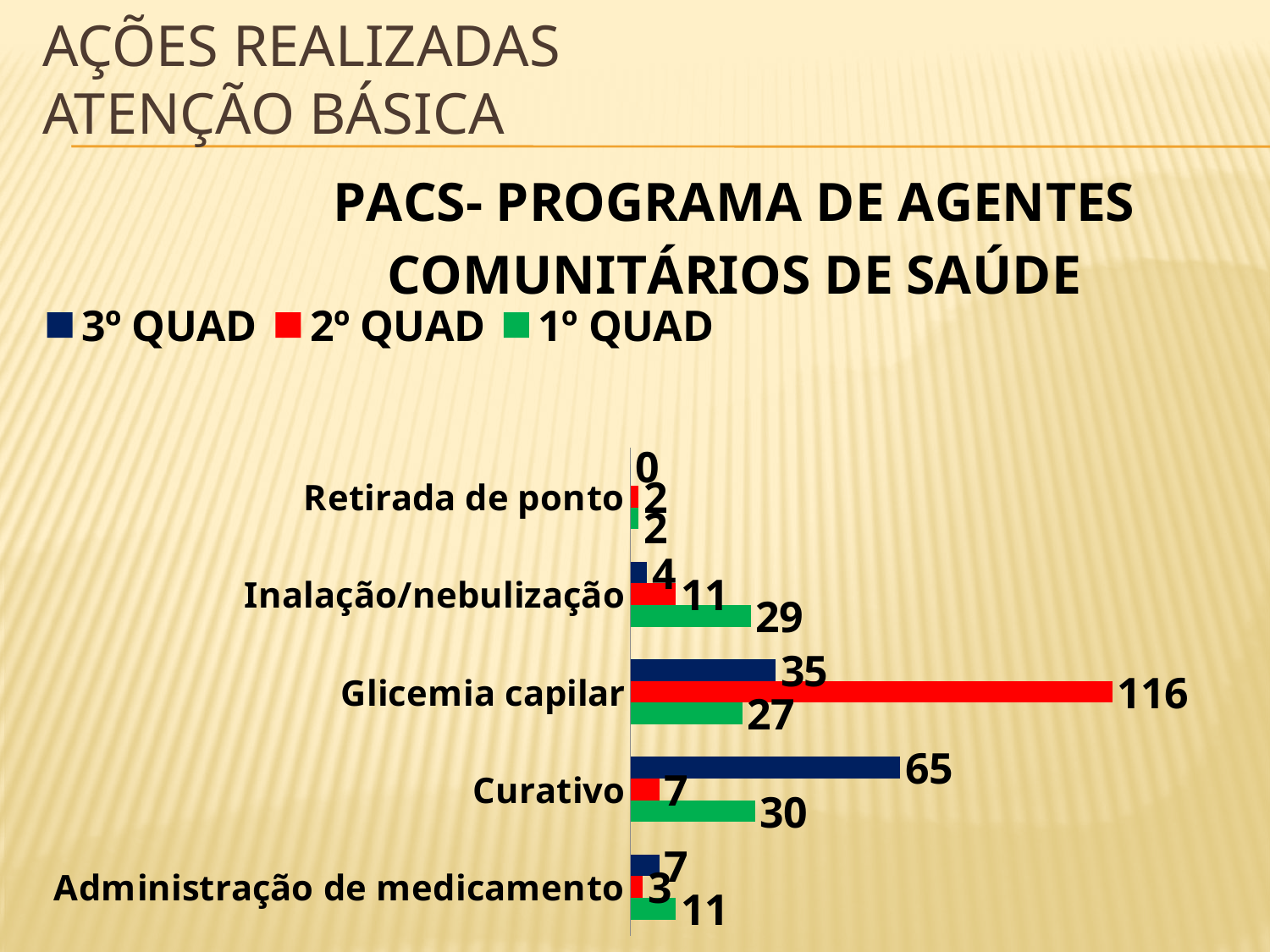
Which category has the lowest value in the 1º QUAD series? Retirada de ponto What kind of chart is shown on the slide? bar chart What is the value for Curativo in the 3º QUAD series? 65 Which series is shown in red in the legend? 2º QUAD What is the value for Inalação/nebulização in the 1º QUAD series? 29 What is the value for Glicemia capilar in the 2º QUAD series? 116 What is the difference between the 2º QUAD and 3º QUAD values for Glicemia capilar? 81 How many series does the legend list? 3 Which is larger for Curativo: the 3º QUAD value or the 1º QUAD value? 3º QUAD Which category has the highest value in the 2º QUAD series? Glicemia capilar What is the value for Retirada de ponto in the 3º QUAD series? 0 How many categories are shown on the chart? 5